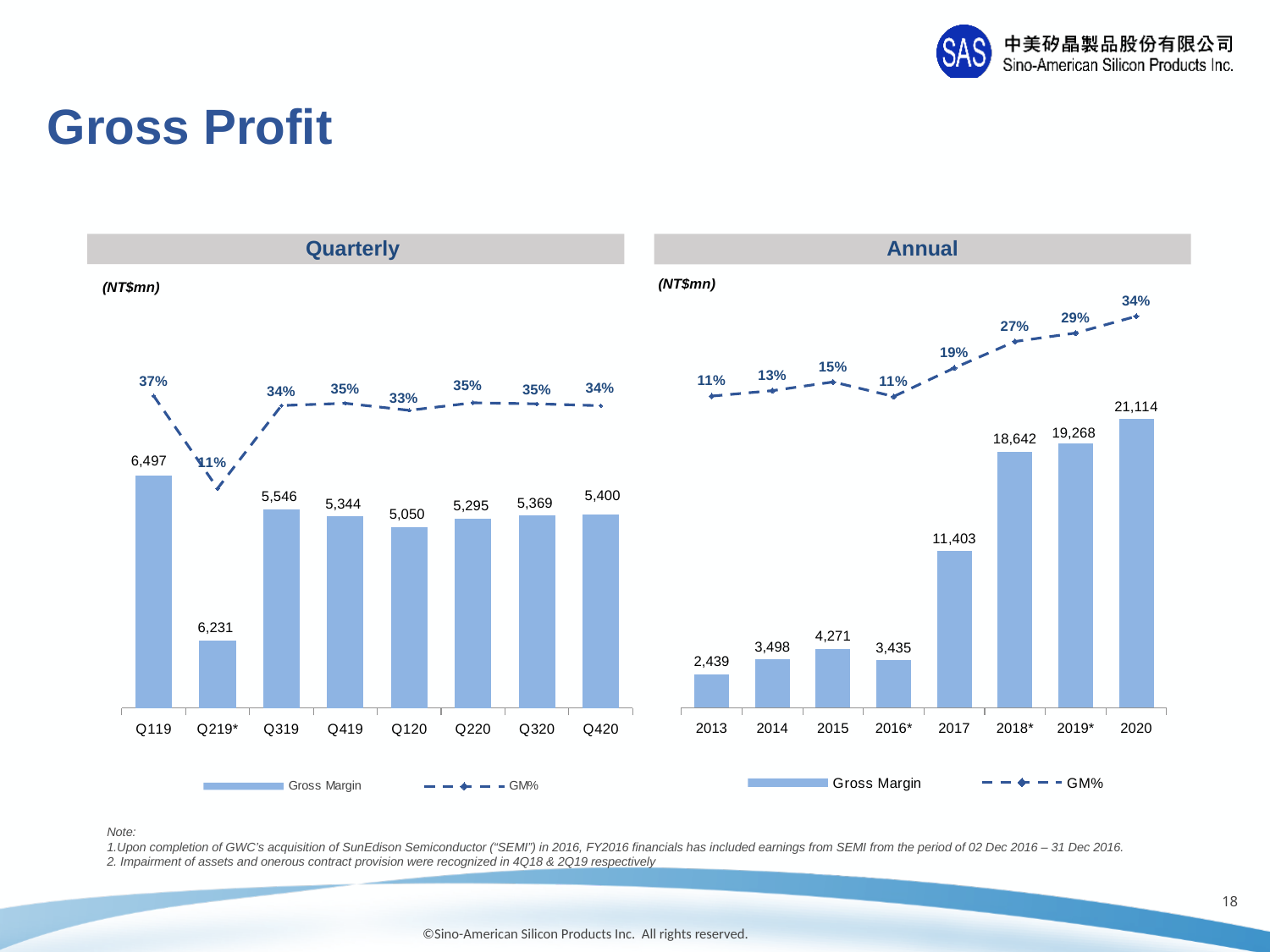
In the Quarterly chart, what is the Gross Margin value for Q319? 5,546 In the Quarterly chart, which quarter has the lowest GM%? Q219* In the Quarterly chart, which quarter has the highest GM%? Q119 In the Annual chart, which is larger, the Gross Margin for 2015 or for 2016*? 2015 In the Annual chart, which year has the highest Gross Margin? 2020 In the Annual chart, which year has the lowest Gross Margin? 2013 In the Quarterly chart, what is the GM% for Q120? 33% In the Annual chart, what is the difference between the Gross Margin values for 2020 and 2019*? 1,846 In the Annual chart, how many series does the legend list? 2 In the Annual chart, what is the Gross Margin value for 2017? 11,403 In the Quarterly chart, what is the difference between the Gross Margin values for Q420 and Q320? 31 In the Annual chart, what is the GM% for 2020? 34%